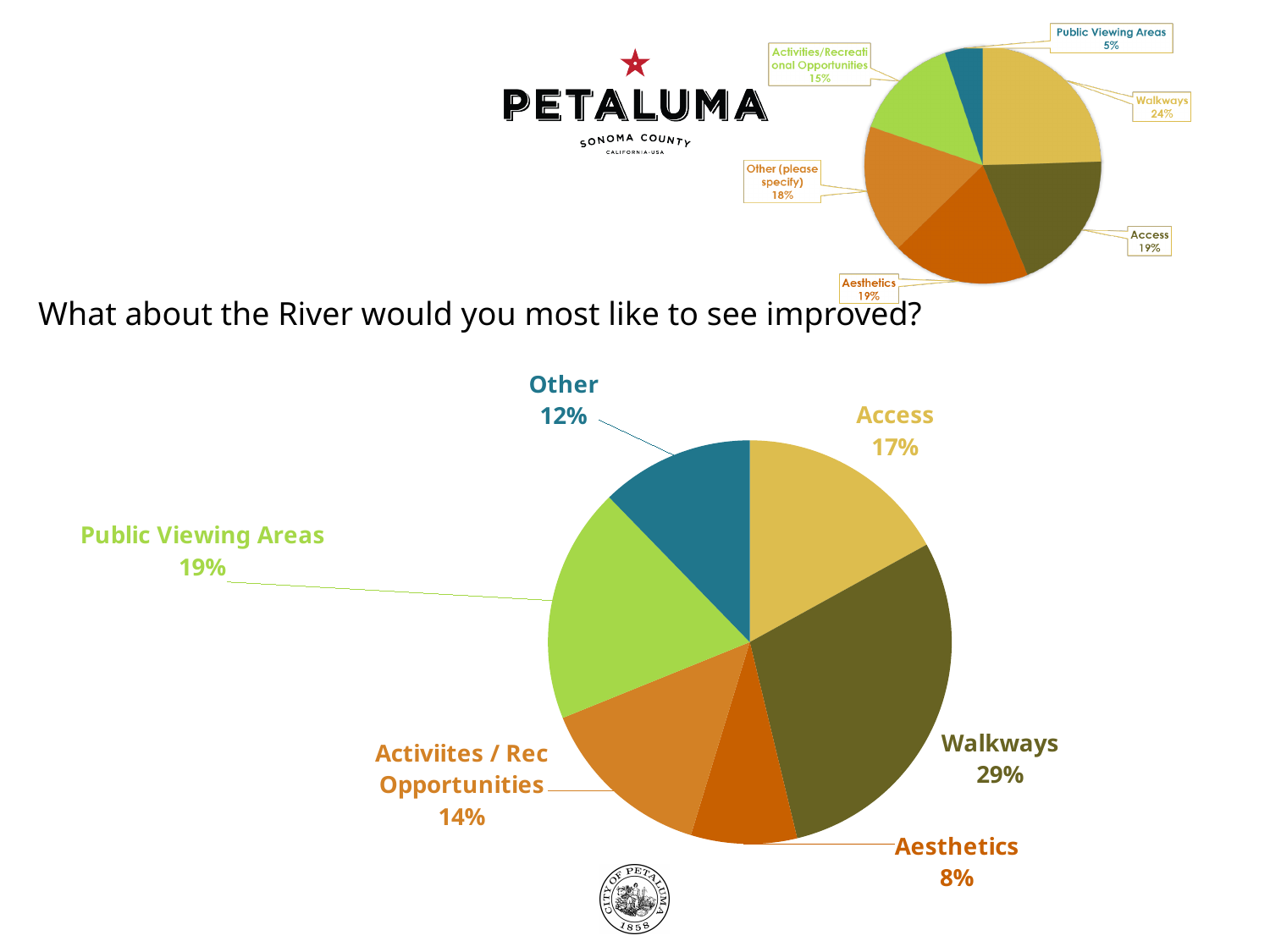
In the large pie chart at the bottom of the slide, which category has the largest share? Walkways What type of chart is the large chart at the bottom of the slide? Pie chart In the large pie chart at the bottom of the slide, what is the difference between the shares for Public Viewing Areas and Other? 7% In the small pie chart at the top right of the slide, which category has the smallest share? Public Viewing Areas In the large pie chart at the bottom of the slide, what share is shown for Aesthetics? 8% How many slices does the large pie chart at the bottom of the slide have? 6 In the large pie chart at the bottom of the slide, which is larger: Access or Activiites / Rec Opportunities? Access In the small pie chart at the top right of the slide, what is the difference between the shares for Other (please specify) and Activities/Recreational Opportunities? 3% What question is written as the title above the large pie chart? What about the River would you most like to see improved? In the large pie chart at the bottom of the slide, which category has the smallest share? Aesthetics In the large pie chart at the bottom of the slide, what share is shown for Walkways? 29% In the small pie chart at the top right of the slide, what share is shown for Walkways? 24%